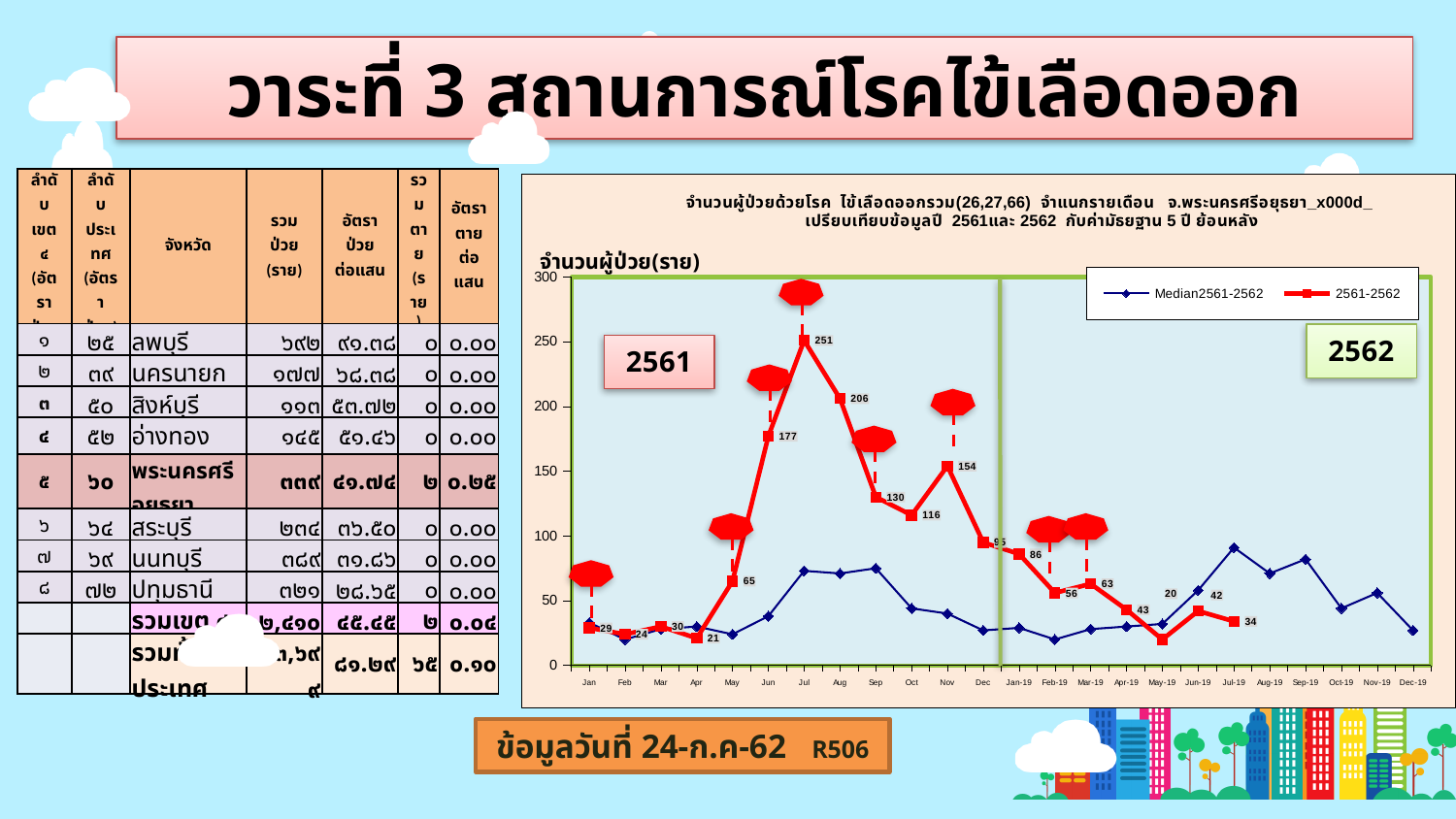
In the line chart, is the value of the Median2561-2562 series for Jul-19 greater or less than 50? greater In the line chart, what is the value of the 2561-2562 series for Nov? 154 What colour is the 2561-2562 series line in the chart? red In the line chart, what is the difference between the 2561-2562 values for Jul and Aug? 45 In the line chart, which is larger for the 2561-2562 series: Sep or Oct? Sep In the line chart, what is the value of the 2561-2562 series for Feb-19? 56 How many months are shown on the x axis of the line chart? 24 In the line chart, what is the value of the 2561-2562 series for Jun? 177 How many series does the legend of the line chart list? 2 In the line chart, which month has the highest value for the 2561-2562 series? Jul In the line chart, what is the value of the 2561-2562 series for Jul? 251 What type of chart is shown on the slide? line chart